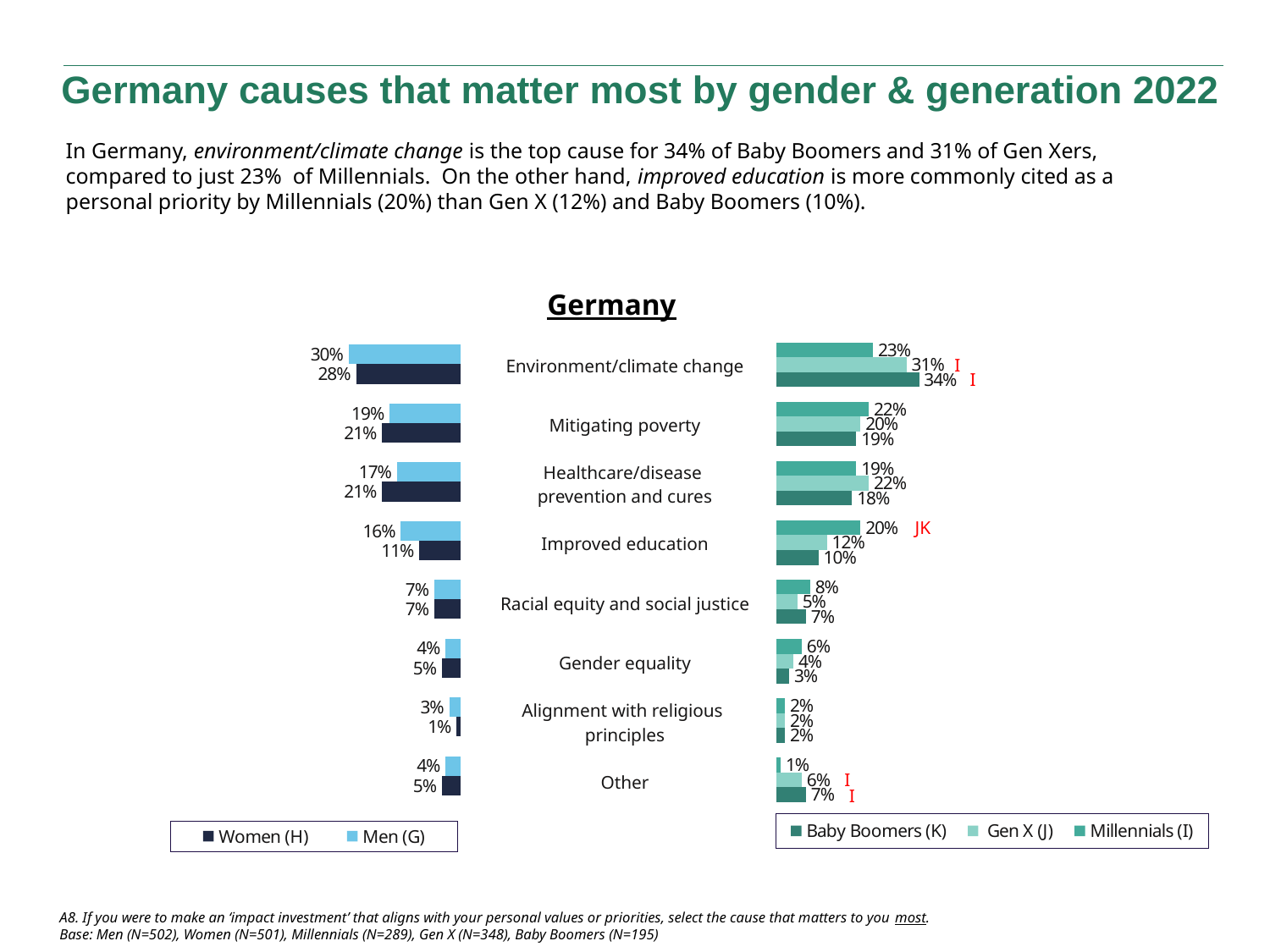
In the right chart (by generation), which cause has the lowest value for Millennials? Other In the left chart (Women/Men), what percentage of women cite Improved education? 11% In the right chart (by generation), what percentage of Baby Boomers cite Environment/climate change? 34% In the right chart (by generation), which is larger for Mitigating poverty: Millennials or Baby Boomers? Millennials What type of chart is the left chart (Women/Men)? Bar chart In the left chart (Women/Men), which cause has the highest value for women? Environment/climate change In the right chart (by generation), what percentage of Millennials cite Improved education? 20% In the left chart (Women/Men), what is the difference between women and men for Healthcare/disease prevention and cures? 4% In the right chart (by generation), what is the difference between Gen X and Baby Boomers for Environment/climate change? 3% How many causes (categories) are shown in the left chart (Women/Men)? 8 How many series does the legend of the right chart (by generation) list? 3 In the left chart (Women/Men), what percentage of men cite Environment/climate change as the cause that matters most? 30%